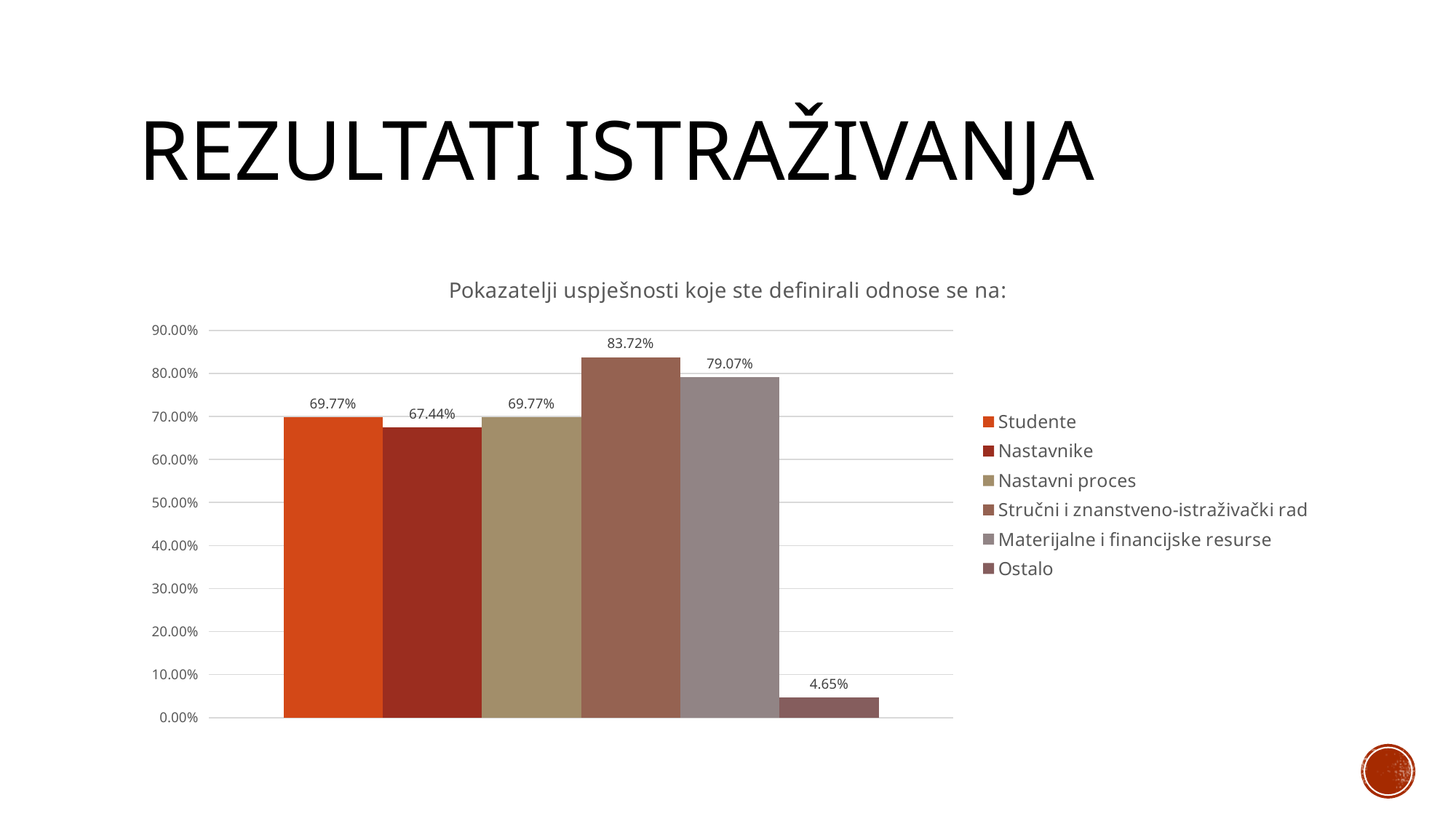
How many series does the legend list? 6 What is the value for Stručni i znanstveno-istraživački rad? 83.72% What is the title of the chart? Pokazatelji uspješnosti koje ste definirali odnose se na: What kind of chart is shown on the slide? Bar chart What is the value for Materijalne i financijske resurse? 79.07% What is the difference between the values for Stručni i znanstveno-istraživački rad and Materijalne i financijske resurse? 4.65% What is the value for Nastavnike? 67.44% Which category has the lowest value? Ostalo Which is larger, the value for Nastavnike or the value for Materijalne i financijske resurse? Materijalne i financijske resurse What is the value for Ostalo? 4.65% Which category has the highest value? Stručni i znanstveno-istraživački rad What is the value for Studente? 69.77%